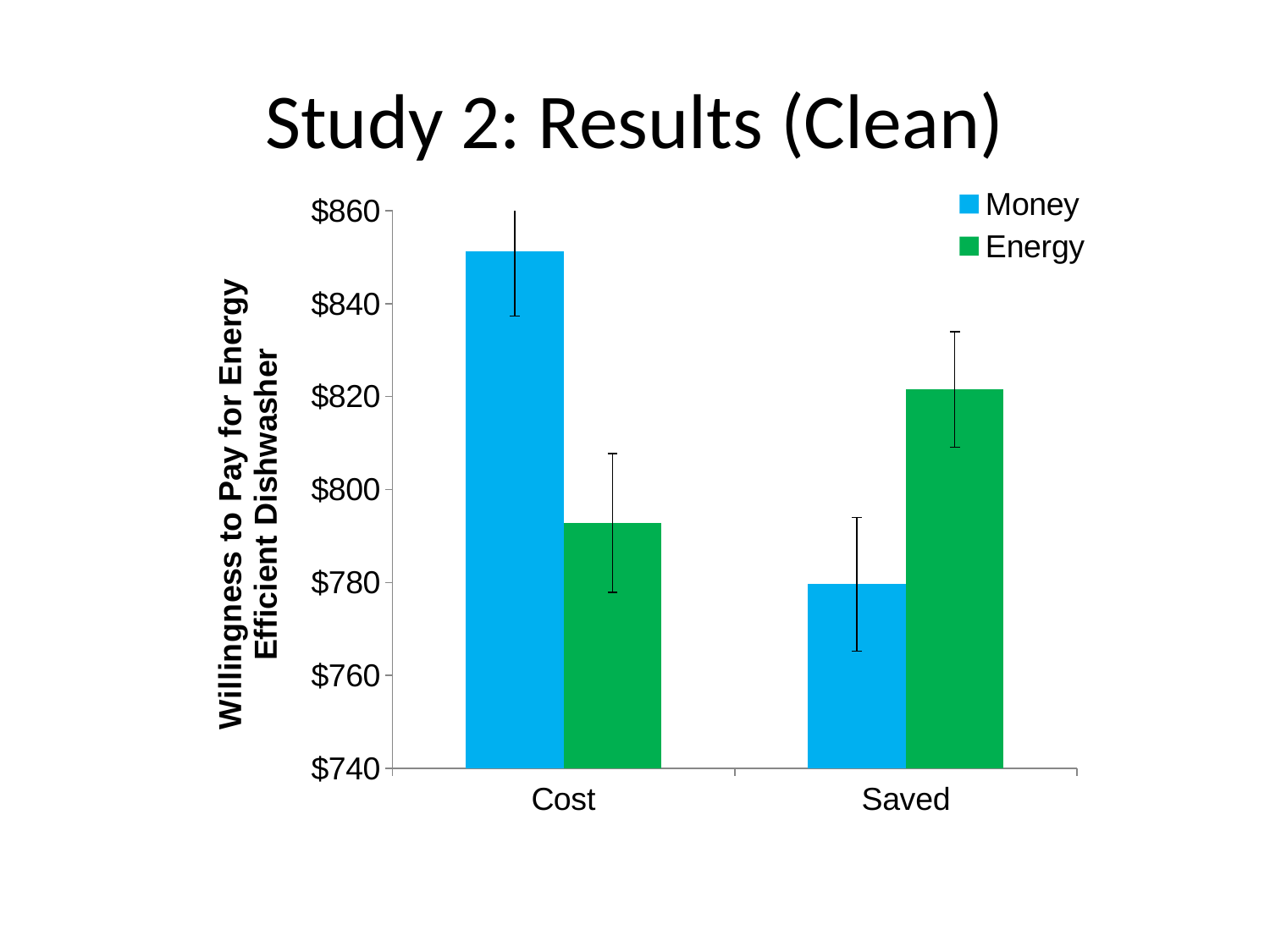
How many series does the legend list? 2 Is the Energy value for Cost greater or less than $800? less For the Cost category, which series has the larger value, Money or Energy? Money For the Saved category, which series has the larger value, Money or Energy? Energy Is the Energy value for Saved greater or less than $800? greater How many categories are shown on the x axis? 2 What kind of chart is shown on the slide? bar chart Is the Money value for Cost greater or less than $840? greater Which colour represents the Energy series in the legend? green Which series and category combination has the highest bar? Money, Cost Which series and category combination has the lowest bar? Money, Saved What is the title of the y axis? Willingness to Pay for Energy Efficient Dishwasher